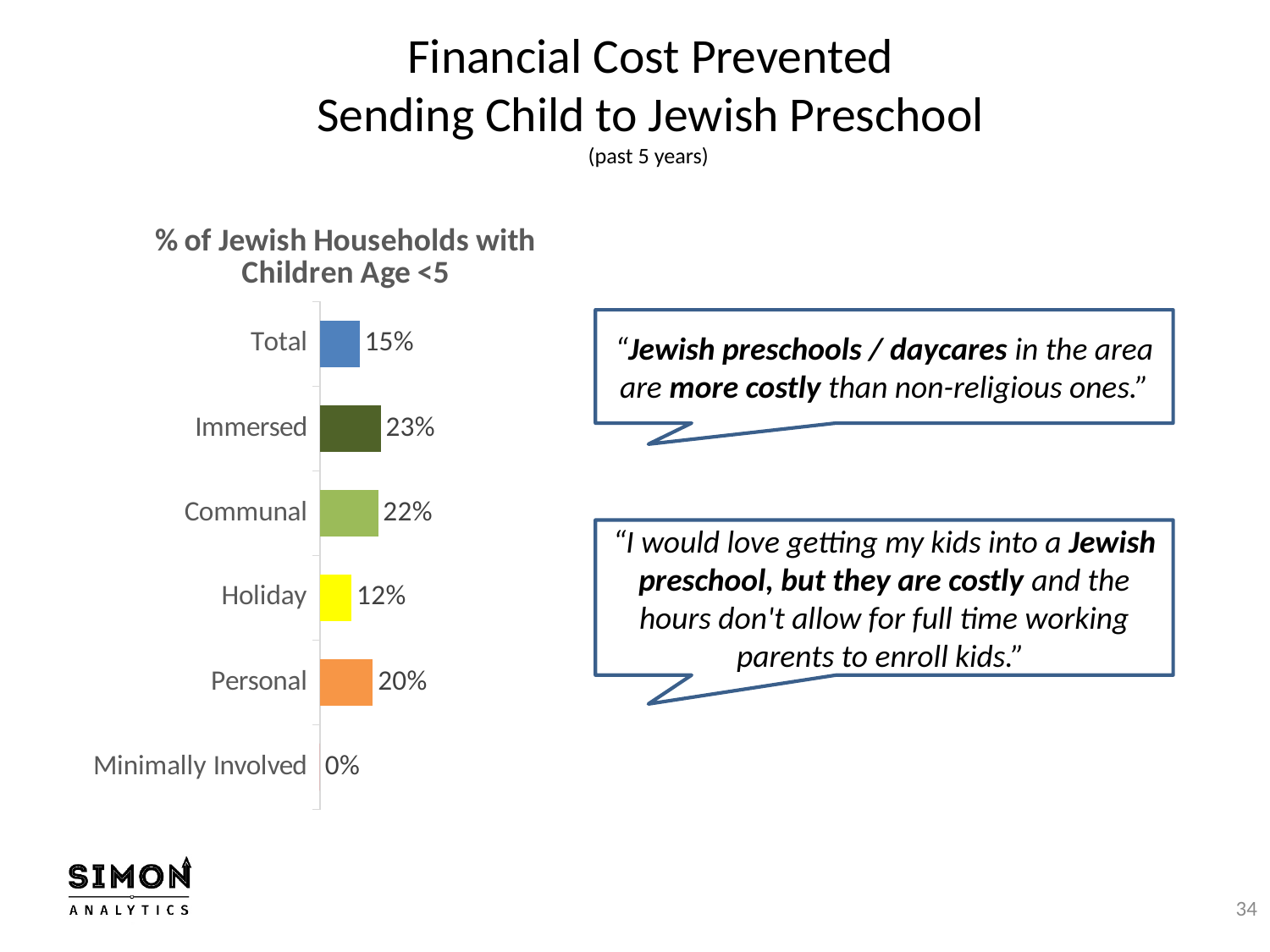
What is the value for Minimally Involved? 0% What is the value for Total? 15% Which is larger, the value for Communal or the value for Personal? Communal How many categories are shown in the chart? 6 What is the difference between the values for Personal and Total? 5% Which category has the highest value? Immersed What is the value for Immersed? 23% What is the difference between the values for Immersed and Holiday? 11% What is the value for Holiday? 12% What is the title of the chart? % of Jewish Households with Children Age <5 Which category has the lowest value? Minimally Involved What kind of chart is shown on the slide? Bar chart